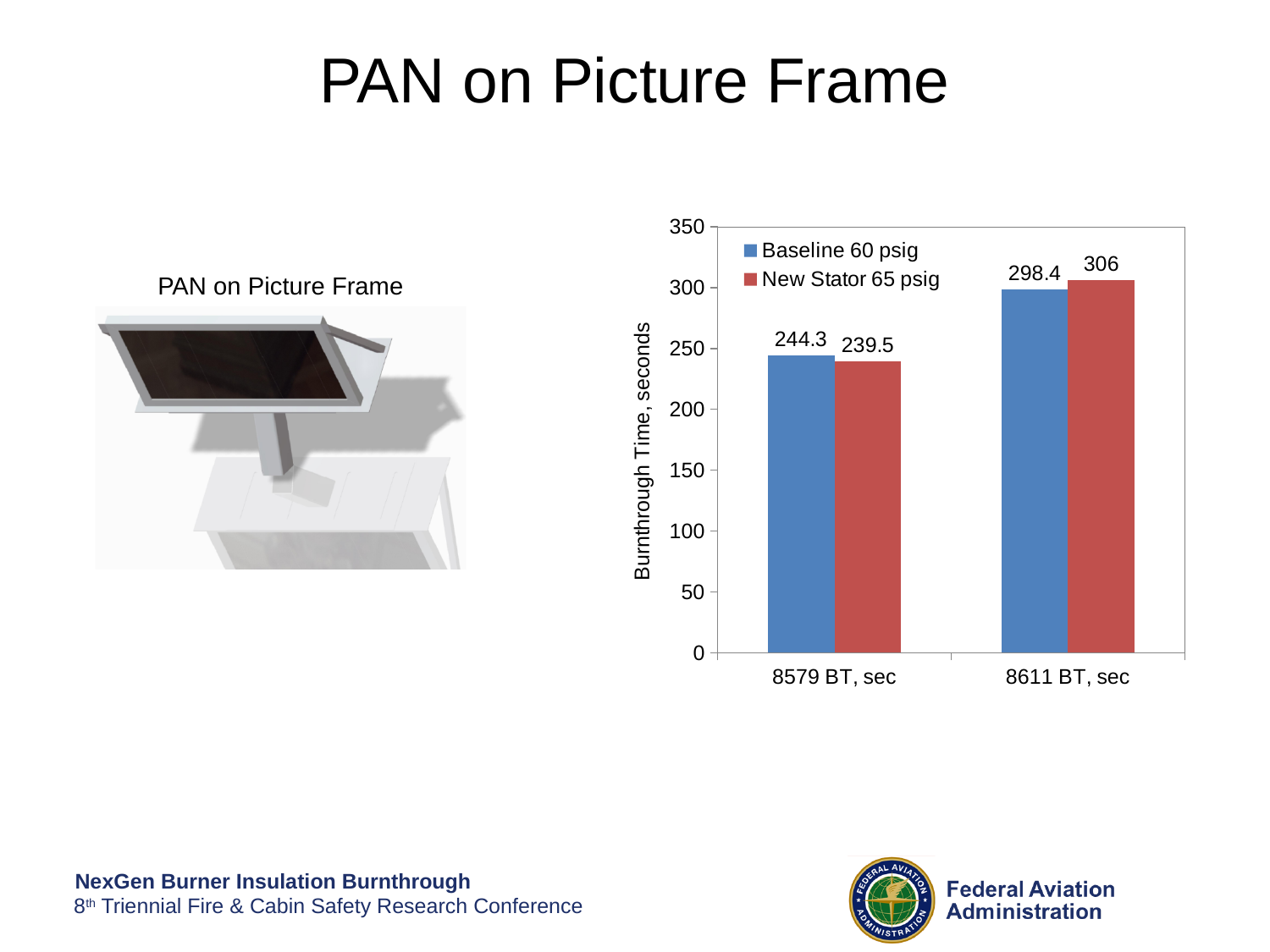
What is the label of the vertical axis of the chart? Burnthrough Time, seconds What is the Baseline 60 psig value for 8579 BT, sec? 244.3 What is the difference between the Baseline 60 psig and New Stator 65 psig values for 8579 BT, sec? 4.8 Which category has the lowest New Stator 65 psig value? 8579 BT, sec Which category has the highest Baseline 60 psig value? 8611 BT, sec For 8611 BT, sec, which is larger: Baseline 60 psig or New Stator 65 psig? New Stator 65 psig What is the New Stator 65 psig value for 8611 BT, sec? 306 How many series does the legend list? 2 What is the New Stator 65 psig value for 8579 BT, sec? 239.5 What is the difference between the New Stator 65 psig and Baseline 60 psig values for 8611 BT, sec? 7.6 What kind of chart is shown on the slide? Bar chart What is the Baseline 60 psig value for 8611 BT, sec? 298.4